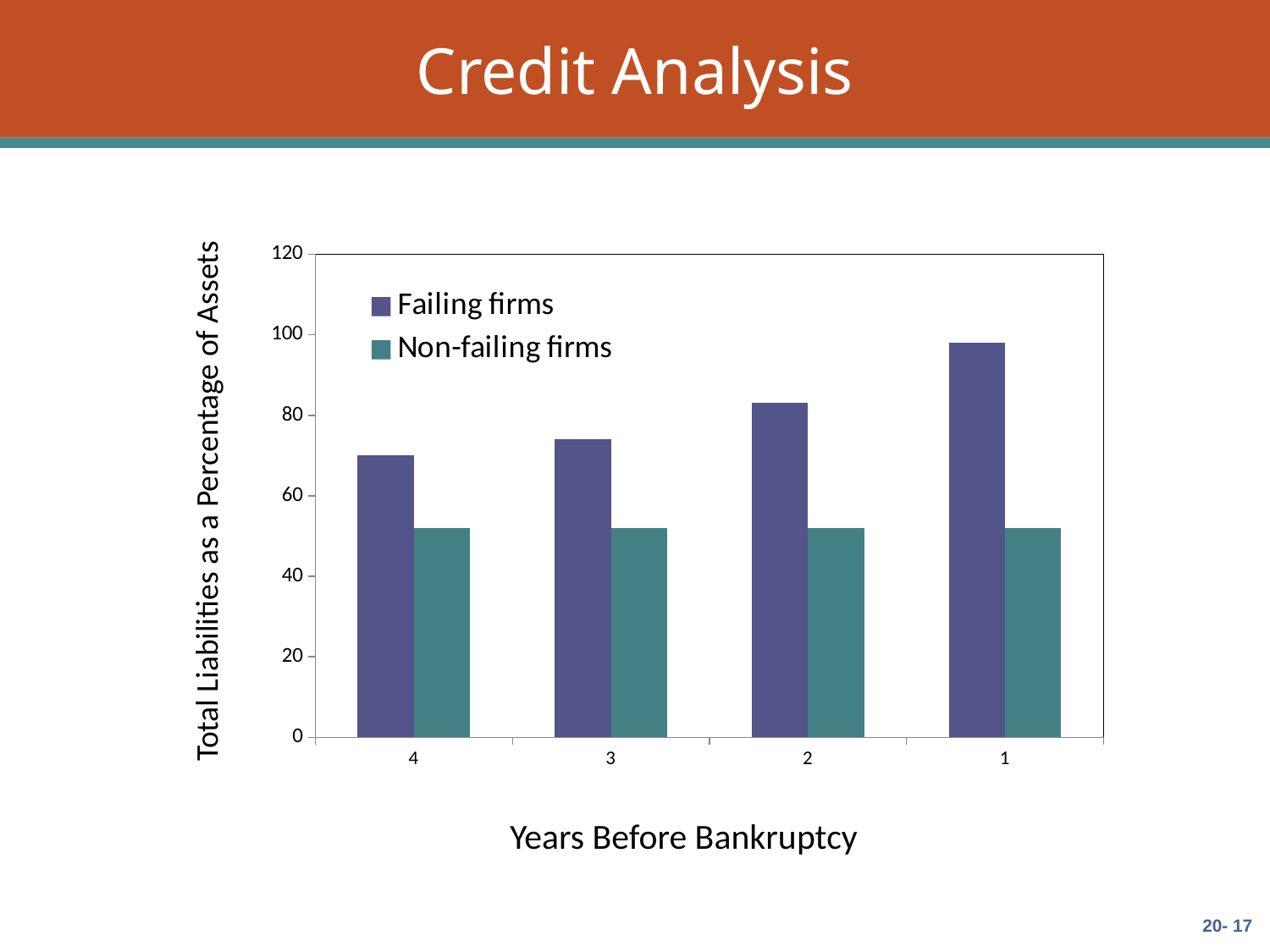
Is the value for Failing firms at 4 years before bankruptcy greater or less than 60? greater At 3 years before bankruptcy, which is larger: Failing firms or Non-failing firms? Failing firms Do the values for Failing firms rise or fall moving from 4 years to 1 year before bankruptcy along the x axis? rise What is the title of the x axis? Years Before Bankruptcy Is the value for Non-failing firms at 2 years before bankruptcy greater or less than 60? less For Failing firms, which year before bankruptcy has the highest value? 1 For Failing firms, which year before bankruptcy has the lowest value? 4 Is the value for Failing firms at 1 year before bankruptcy greater or less than 80? greater What is the title of the y axis? Total Liabilities as a Percentage of Assets What kind of chart is shown on the slide? bar chart How many categories are shown on the x axis? 4 How many series does the legend list? 2